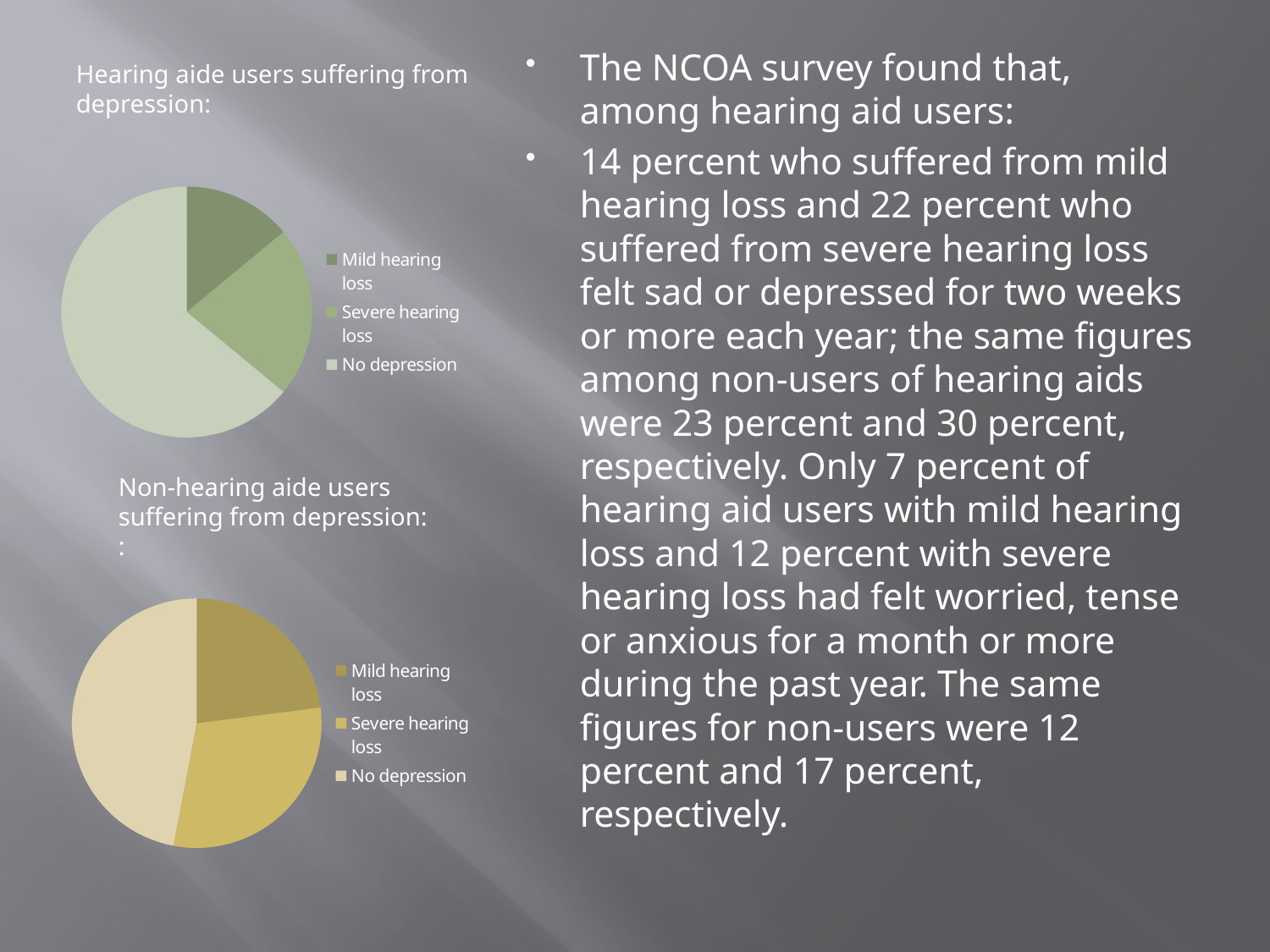
In the 'Non-hearing aide users suffering from depression' chart, how many categories does the legend list? 3 In the 'Non-hearing aide users suffering from depression' chart, which slice is larger: No depression or Severe hearing loss? No depression In the 'Hearing aide users suffering from depression' chart, how many slices does the pie have? 3 In the 'Hearing aide users suffering from depression' chart, which category has the largest slice? No depression What are the three legend entries of the bottom pie chart? Mild hearing loss, Severe hearing loss, No depression In the 'Non-hearing aide users suffering from depression' chart, which category has the smallest slice? Mild hearing loss In the 'Hearing aide users suffering from depression' chart, which slice is larger: Mild hearing loss or Severe hearing loss? Severe hearing loss What kind of chart is the 'Hearing aide users suffering from depression' chart? Pie chart What kind of chart is the 'Non-hearing aide users suffering from depression' chart? Pie chart In the 'Non-hearing aide users suffering from depression' chart, which category has the largest slice? No depression In the 'Hearing aide users suffering from depression' chart, which category has the smallest slice? Mild hearing loss What is the title of the top chart on the slide? Hearing aide users suffering from depression: